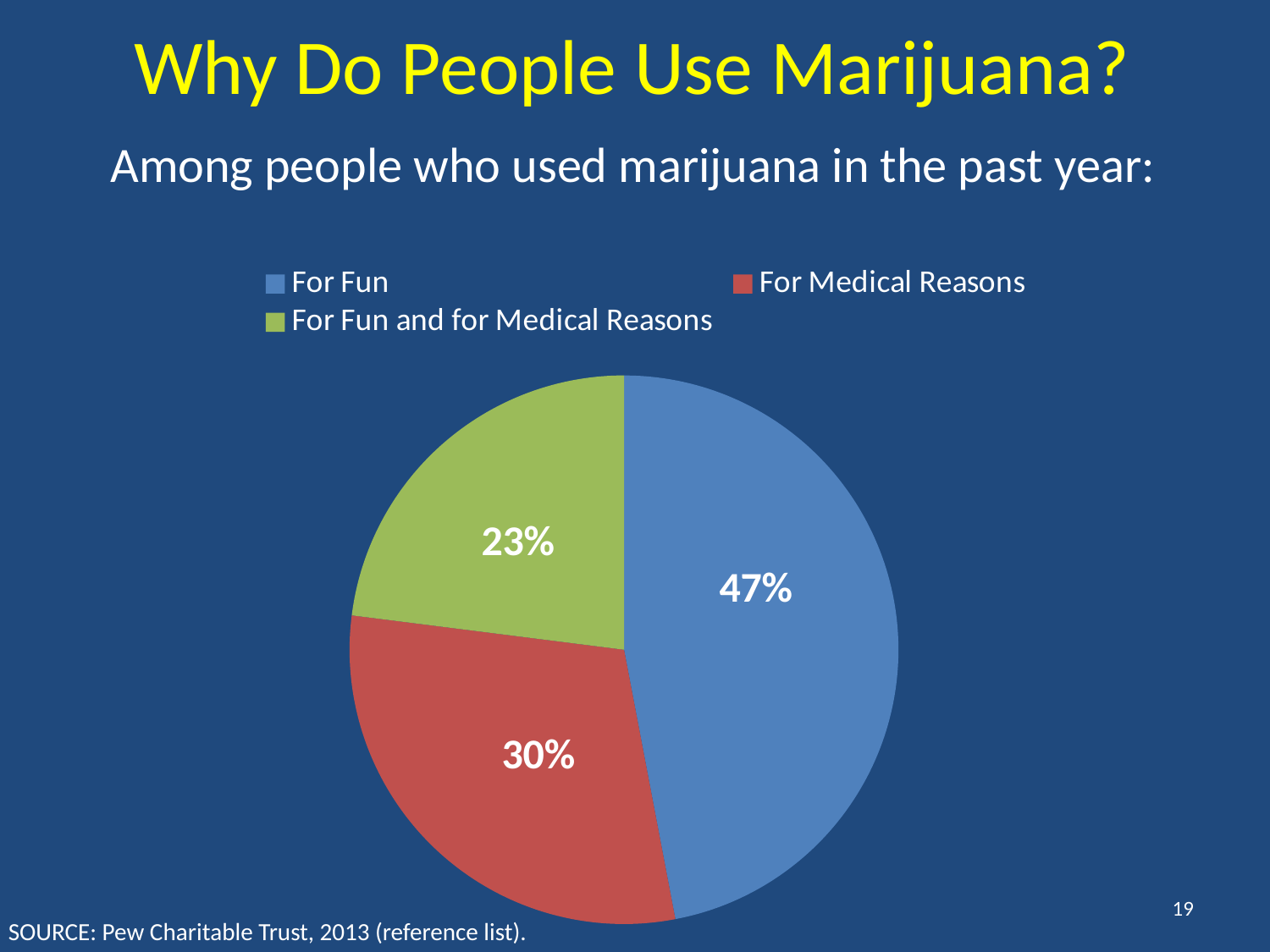
How many entries does the legend list? 3 What percentage of past-year marijuana users used it for fun? 47% How many percentage points larger is the 'For Fun' slice than the 'For Medical Reasons' slice? 17 What kind of chart is shown on the slide? pie chart How many percentage points larger is the 'For Medical Reasons' slice than the 'For Fun and for Medical Reasons' slice? 7 What percentage of past-year marijuana users used it for medical reasons? 30% How many slices does the pie chart have? 3 What colour is the 'For Medical Reasons' slice? red Which reason for using marijuana has the largest share of the pie? For Fun Which reason for using marijuana has the smallest share of the pie? For Fun and for Medical Reasons What percentage of past-year marijuana users used it for fun and for medical reasons? 23% Which is larger: the share for 'For Medical Reasons' or the share for 'For Fun and for Medical Reasons'? For Medical Reasons